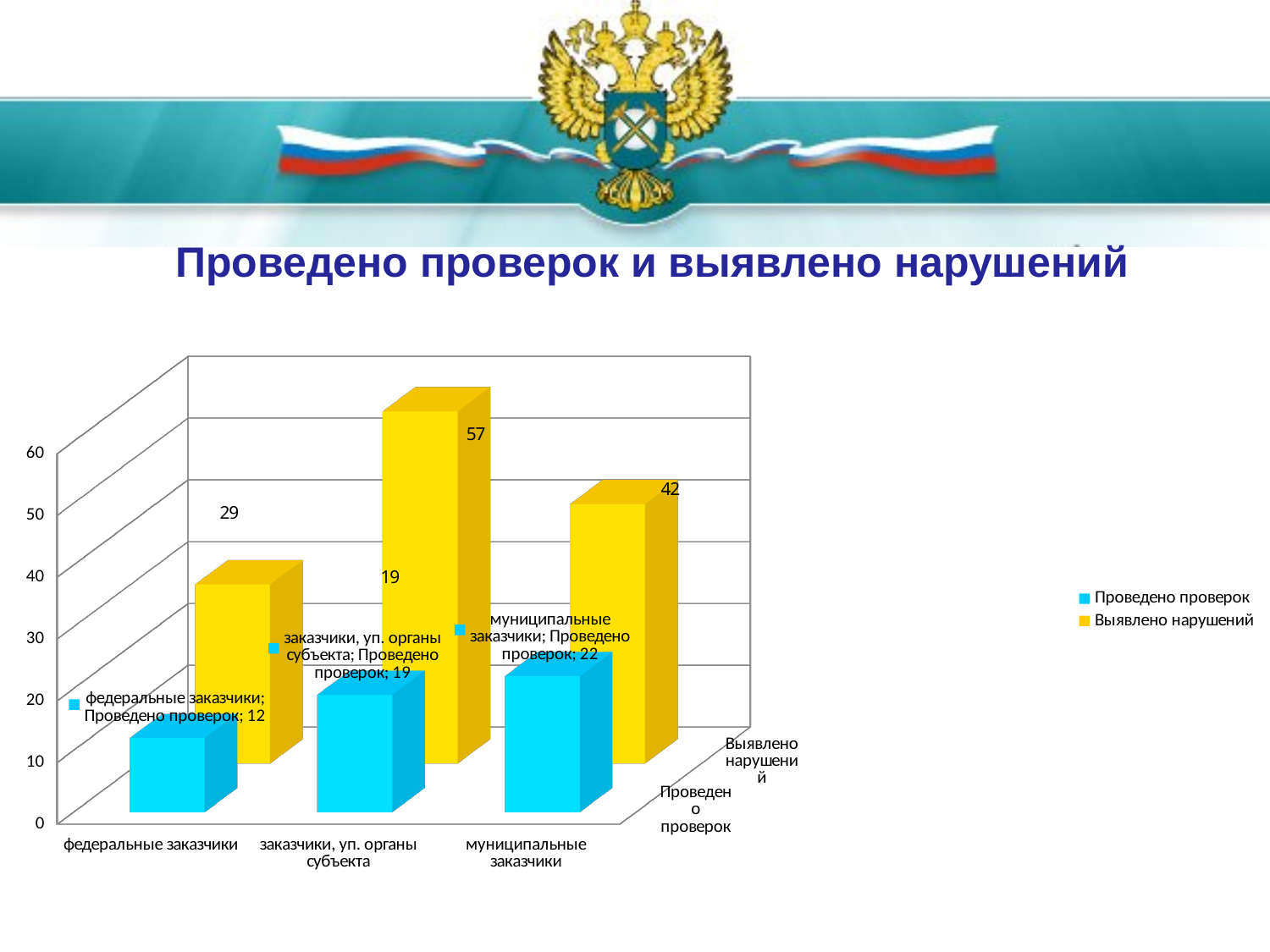
Which category has the highest value of Выявлено нарушений? заказчики, уп. органы субъекта What is the value of Проведено проверок for муниципальные заказчики? 22 What is the value of Проведено проверок for федеральные заказчики? 12 What kind of chart is shown on the slide? bar chart Which category has the lowest value of Проведено проверок? федеральные заказчики Which is larger: Выявлено нарушений for муниципальные заказчики or Выявлено нарушений for федеральные заказчики? муниципальные заказчики How many series does the legend list? 2 What is the value of Выявлено нарушений for заказчики, уп. органы субъекта? 57 What is the title of the chart? Проведено проверок и выявлено нарушений How many categories are shown on the x axis? 3 What is the difference between Выявлено нарушений and Проведено проверок for федеральные заказчики? 17 What is the value of Выявлено нарушений for муниципальные заказчики? 42